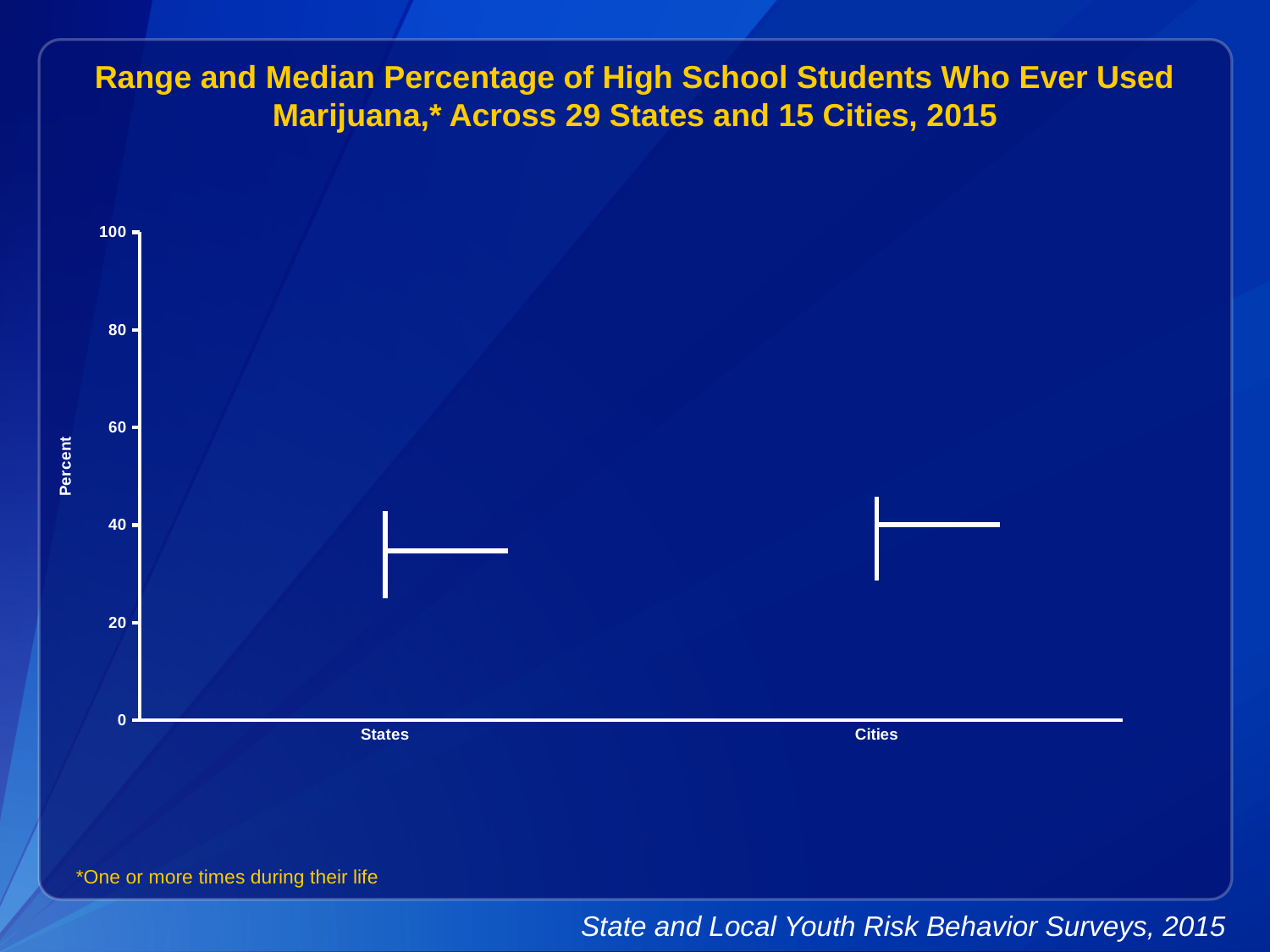
What is the label of the y axis? Percent Is the median value for Cities greater or less than 60? less What are the two categories shown on the x axis? States and Cities Is the bottom of the range for Cities greater or less than 40? less Is the top of the range for Cities greater or less than 40? greater What is the highest value shown on the y axis? 100 Which has the higher median percentage, States or Cities? Cities How many categories are shown on the x axis of the chart? 2